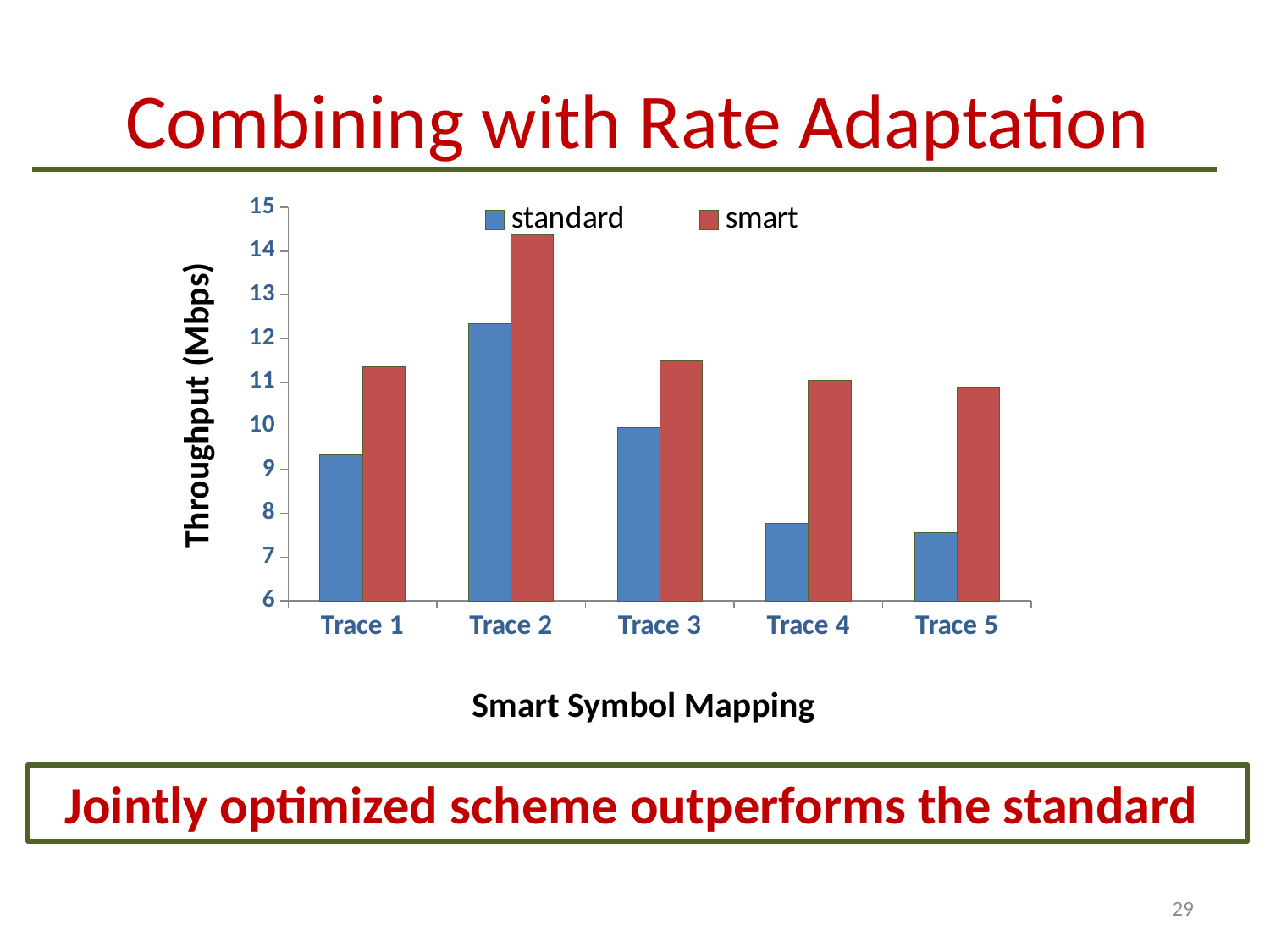
Which trace has the highest standard throughput? Trace 2 For Trace 1, which is larger: the standard or the smart throughput? smart How many series does the legend list? 2 What is the label of the y axis? Throughput (Mbps) What kind of chart is shown on the slide? bar chart Is the standard throughput for Trace 4 greater or less than 8? less Is the smart throughput for Trace 3 greater or less than 11? greater Which trace has the highest smart throughput? Trace 2 For Trace 4, which is larger: the standard or the smart throughput? smart Is the standard throughput for Trace 2 greater or less than 12? greater How many traces (categories) are shown on the x axis? 5